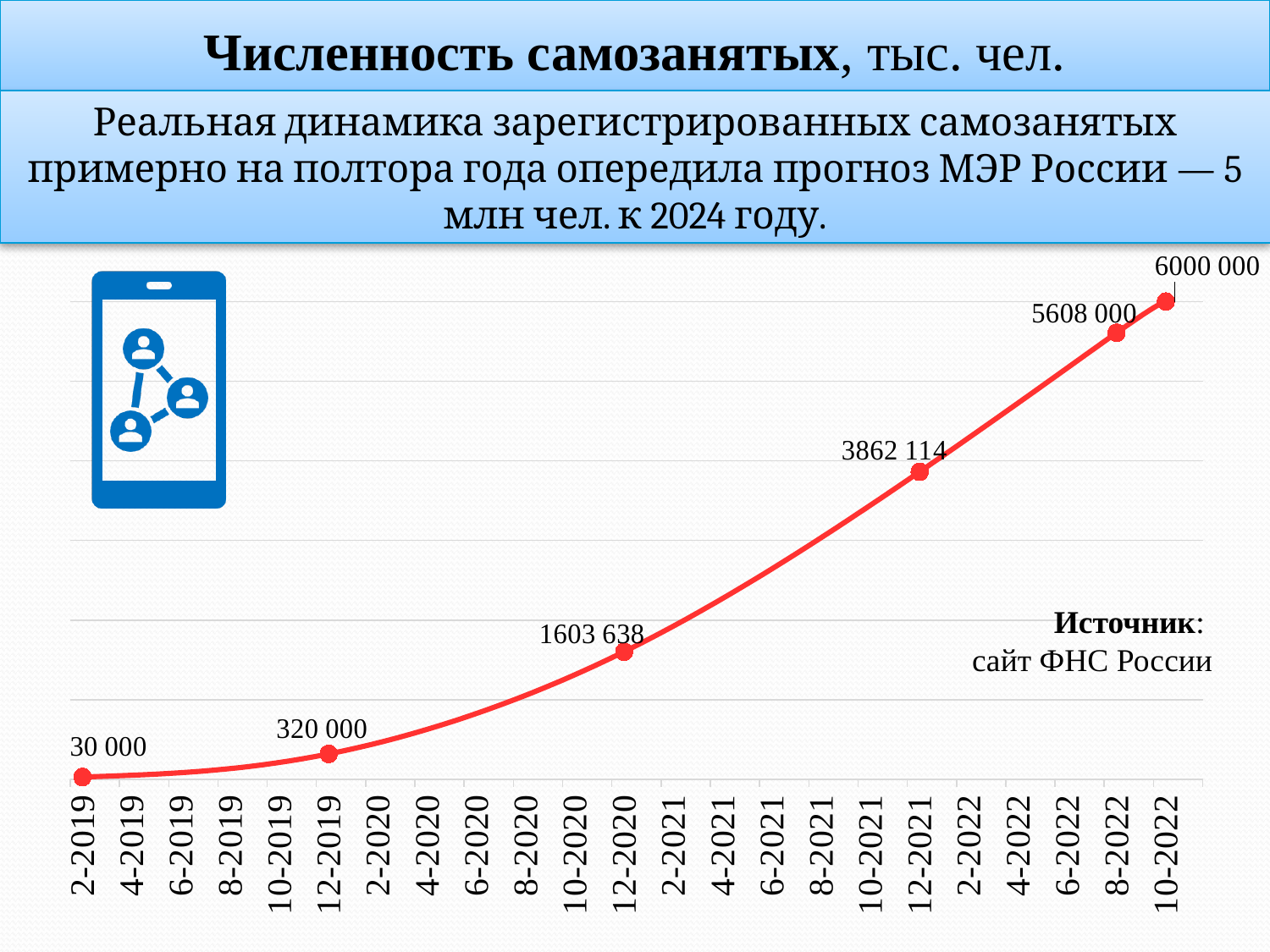
What value is labelled at 2-2019 on the chart? 30 000 Which is larger: the value at 12-2020 or the value at 12-2021? 12-2021 What is the difference between the labelled values at 10-2022 and 8-2022? 392 000 What kind of chart is shown on the slide? line chart What value is labelled at 8-2022 on the chart? 5608 000 What value is labelled at 12-2020 on the chart? 1603 638 How many data points have value labels on the chart? 6 Do the values rise or fall along the x axis from 2-2019 to 10-2022? rise Which labelled point on the chart has the highest value? 10-2022 Which labelled point on the chart has the lowest value? 2-2019 What is the difference between the labelled values at 12-2019 and 2-2019? 290 000 What value is labelled at 12-2021 on the chart? 3862 114